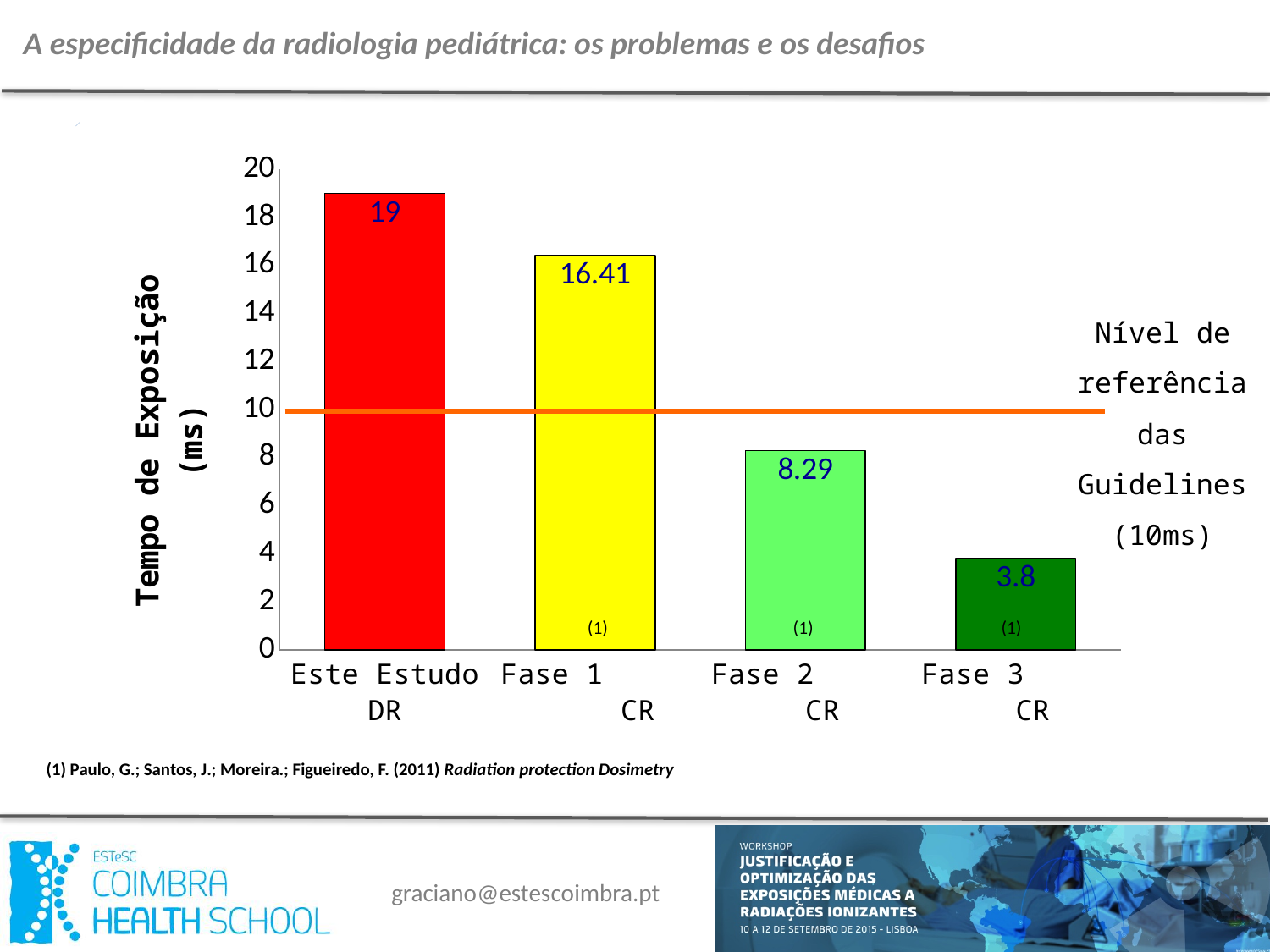
What is the exposure time value for Este Estudo (DR)? 19 What is the exposure time value for Fase 2 (CR)? 8.29 Which is larger, the value for Fase 1 or the value for Fase 2? Fase 1 What is the exposure time value for Fase 1 (CR)? 16.41 What is the exposure time value for Fase 3 (CR)? 3.8 Which category has the lowest exposure time? Fase 3 (CR) How many bars are plotted in the chart? 4 What kind of chart is shown on the slide? Bar chart What is the difference between the exposure time for Este Estudo and Fase 1? 2.59 Which category has the highest exposure time? Este Estudo (DR) What is the difference between the exposure time for Fase 2 and Fase 3? 4.49 What is the reference level (Nível de referência das Guidelines) marked by the horizontal line? 10ms